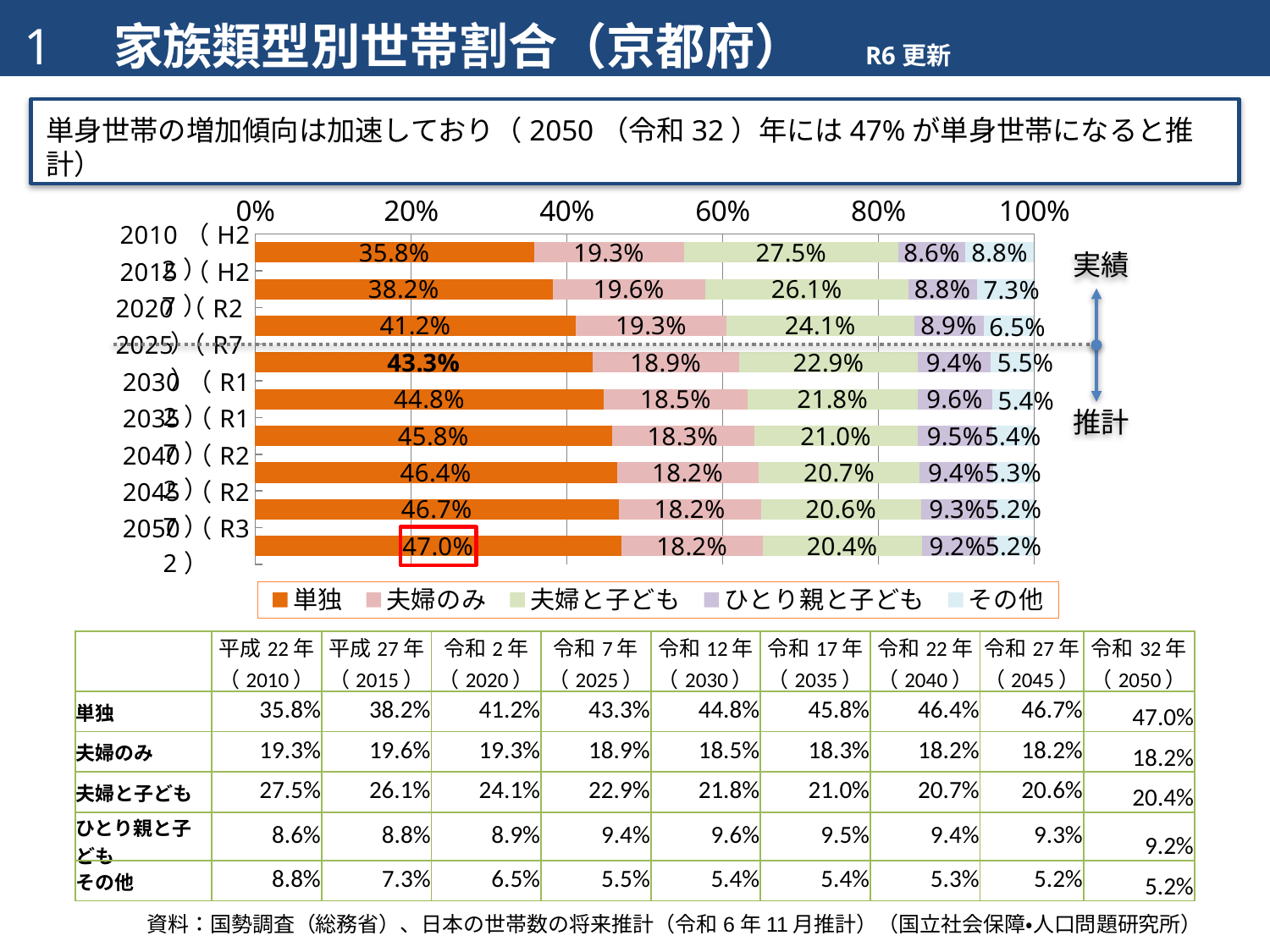
What is the value for ひとり親と子ども in 2030 on the chart? 9.6% What is the value for その他 in 2020 on the chart? 6.5% What is the value for 夫婦と子ども in 2010 on the chart? 27.5% What type of chart is shown on the slide? Stacked bar chart What is the value for 単独 in 2050 on the chart? 47.0% In which year is the 単独 share highest on the chart? 2050 What is the difference between the 単独 value in 2050 and in 2010? 11.2 percentage points In which year is the その他 share lowest on the chart? 2045 and 2050 (5.2%) Does the 夫婦と子ども share rise or fall from 2010 to 2050? Fall How many series does the chart legend list? 5 Which is larger in 2025: 夫婦のみ or 夫婦と子ども? 夫婦と子ども How many years (bars) are shown on the chart? 9